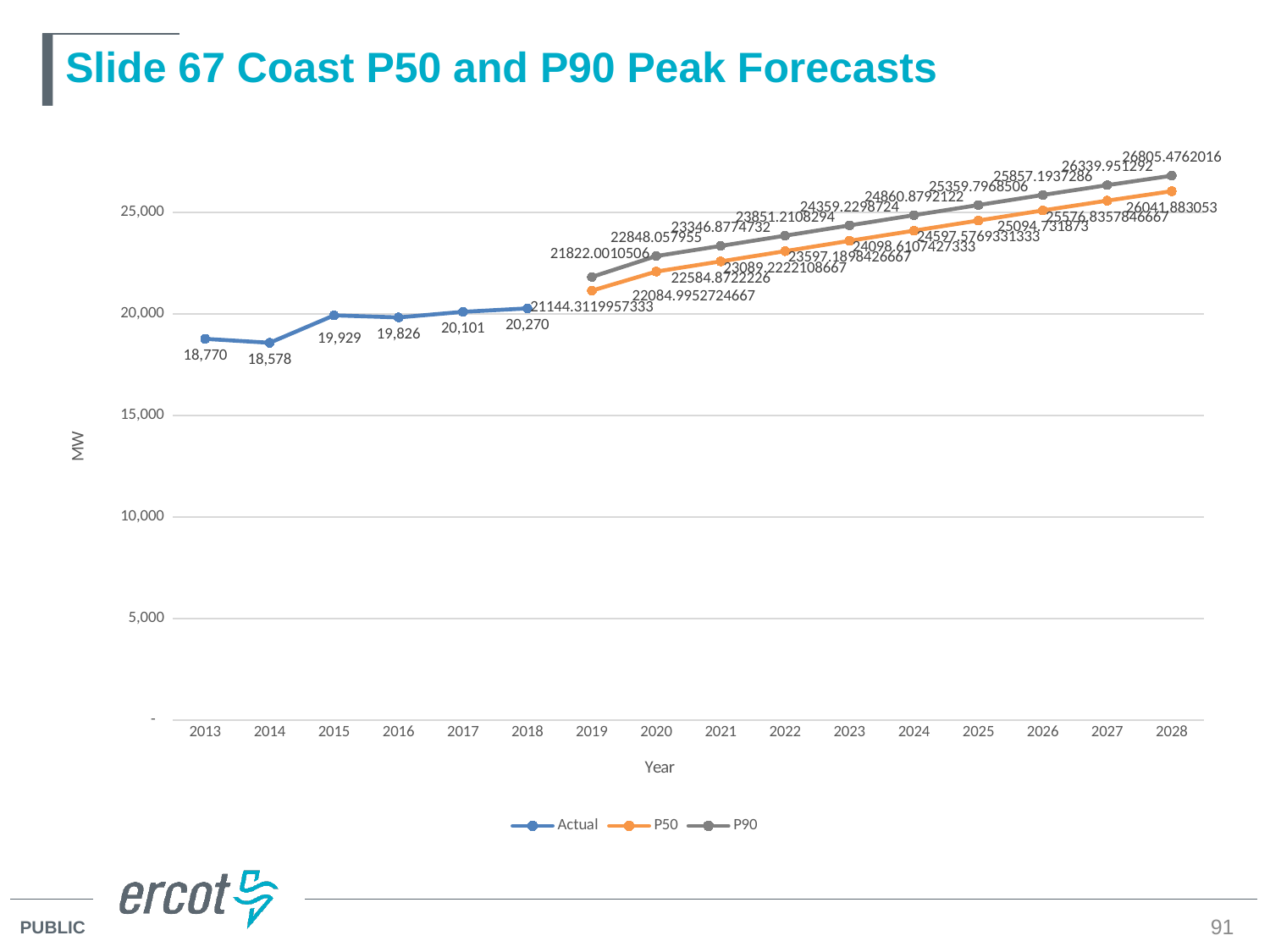
How many series does the legend list? 3 Which year has the lowest Actual value? 2014 What is the P90 forecast value for 2028? 26805.4762016 What is the difference between the Actual values for 2018 and 2013? 1,500 What is the P50 forecast value for 2019? 21144.3119957333 What is the Actual peak value for 2013? 18,770 What is the Actual peak value for 2018? 20,270 Is the Actual value for 2017 greater or less than 20,000? greater Do the P90 forecast values rise or fall from 2019 to 2028? Rise Which is larger in 2020, the P50 value or the P90 value? P90 What kind of chart is shown on the slide? Line chart What is the P90 forecast value for 2019? 21822.0010506